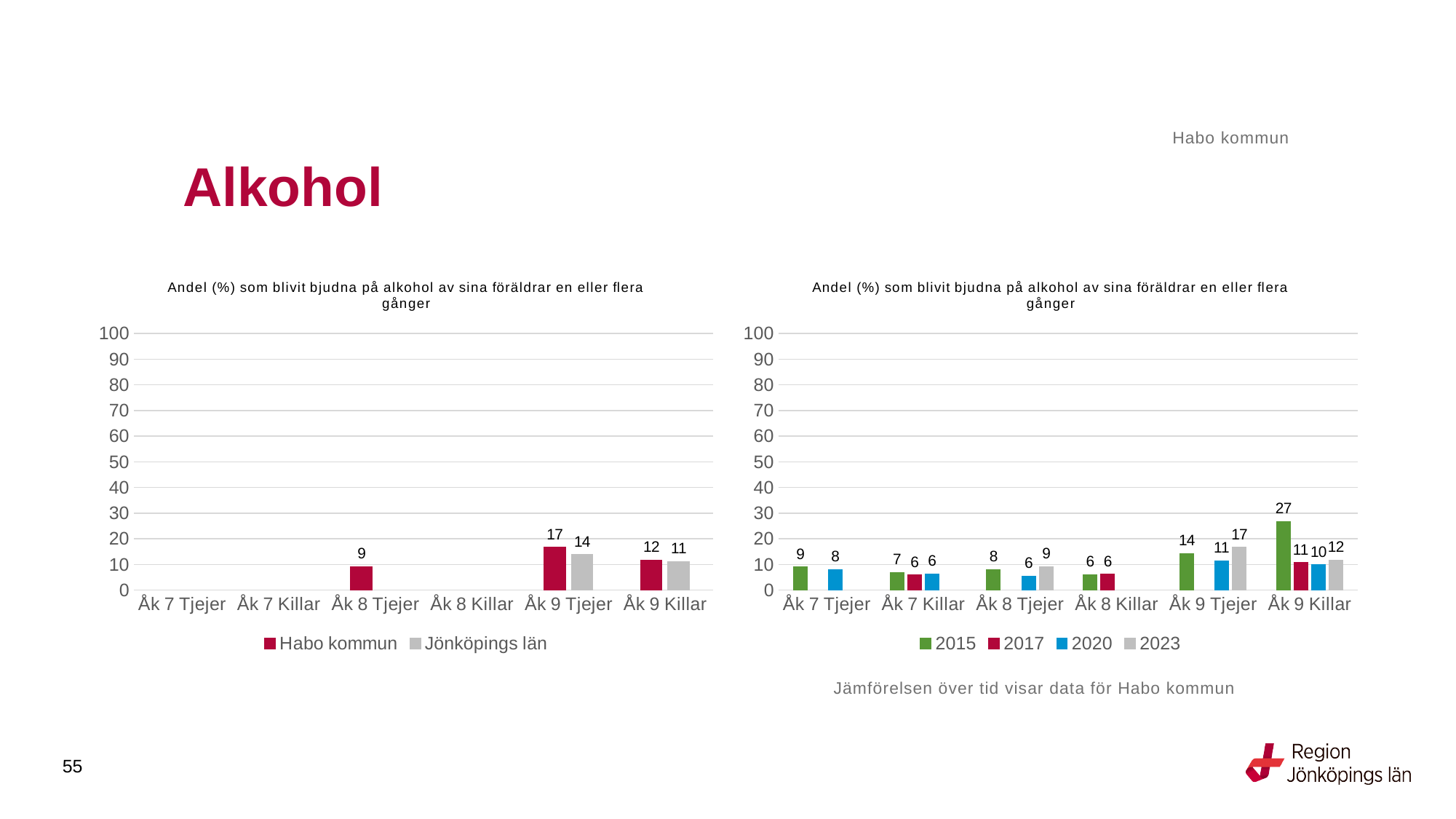
In the right chart, how many categories are shown on the x axis? 6 In the right chart, what is the difference between the 2015 and 2023 values for Åk 9 Killar? 15 In the left chart, which category has the highest Habo kommun value? Åk 9 Tjejer What type of chart is the right chart? Bar chart In the right chart, how many series does the legend list? 4 In the right chart, which is larger for Åk 8 Tjejer, the 2015 value or the 2023 value? 2023 In the left chart, what is the difference between Habo kommun and Jönköpings län for Åk 9 Tjejer? 3 In the left chart, what is the value for Habo kommun for Åk 9 Tjejer? 17 In the right chart, what is the value for 2023 for Åk 9 Tjejer? 17 In the left chart, how many series does the legend list? 2 In the right chart, what is the value for 2015 for Åk 9 Killar? 27 In the left chart, what is the value for Jönköpings län for Åk 9 Killar? 11